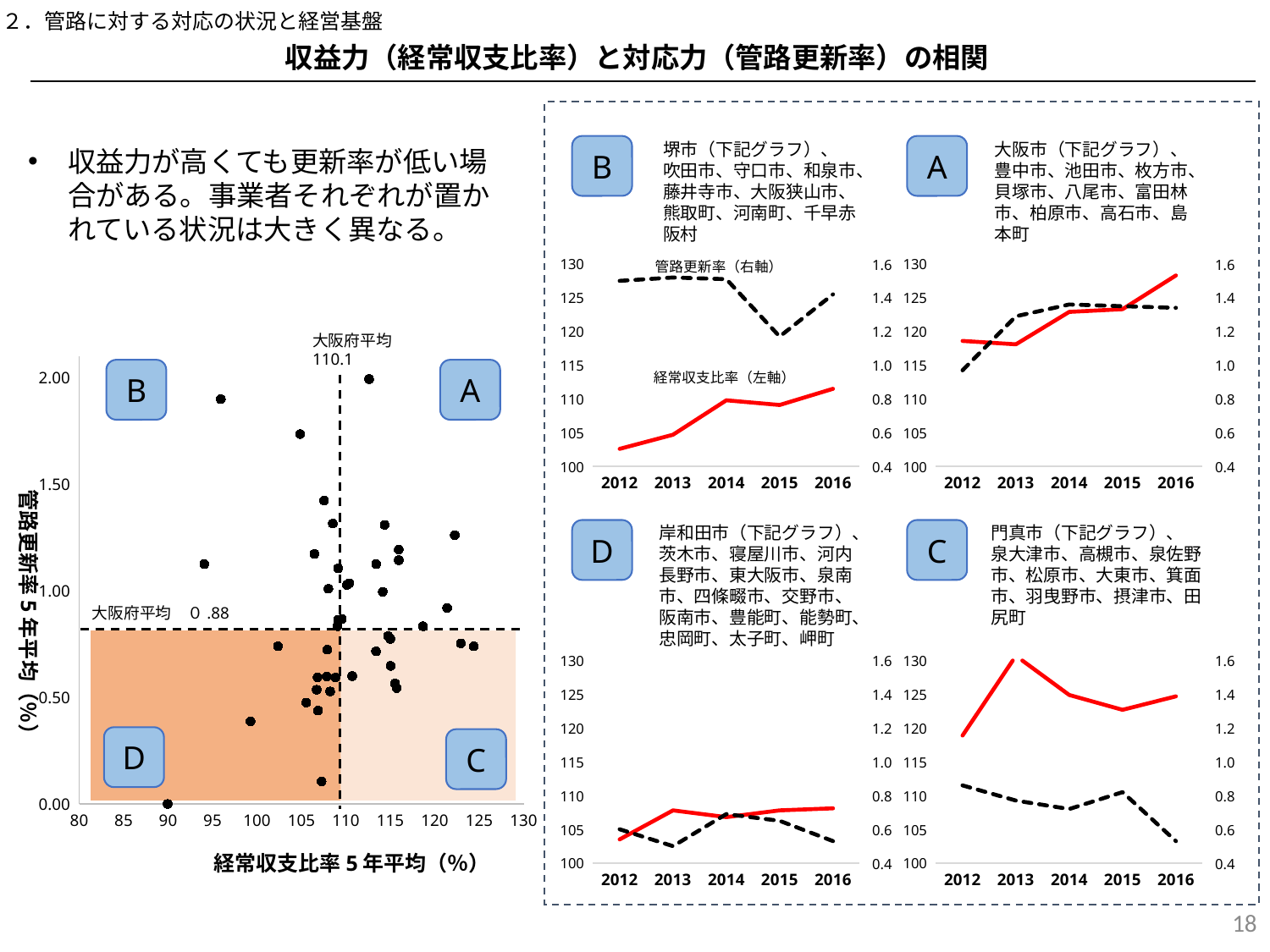
In the 門真市 chart (labelled C), does the 管路更新率 dashed line rise or fall overall from 2012 to 2016? fall On the scatter chart on the left, what is the 大阪府平均 value marked on the vertical dashed line for 経常収支比率? 110.1 On the scatter chart on the left, what is the label of the horizontal axis? 経常収支比率5年平均（%） On the scatter chart on the left, what is the 大阪府平均 value marked on the horizontal dashed line for 管路更新率? 0.88 In the 堺市 chart (labelled B), is the 経常収支比率 value for 2012 greater or less than 105? less In the 大阪市 chart (labelled A), does the 経常収支比率 line rise or fall from 2012 to 2016? rise What kind of chart is the large chart on the left of the slide? scatter chart In the 門真市 chart (labelled C), is the 経常収支比率 value for 2013 greater or less than 125? greater What kind of chart is the 大阪市 chart (top right, labelled A)? line chart In the 大阪市 chart (labelled A), is the 経常収支比率 value for 2016 greater or less than 125? greater How many series are plotted in the 堺市 chart (top, labelled B)? 2 How many years are plotted along the x axis of the 堺市 chart (top, labelled B)? 5